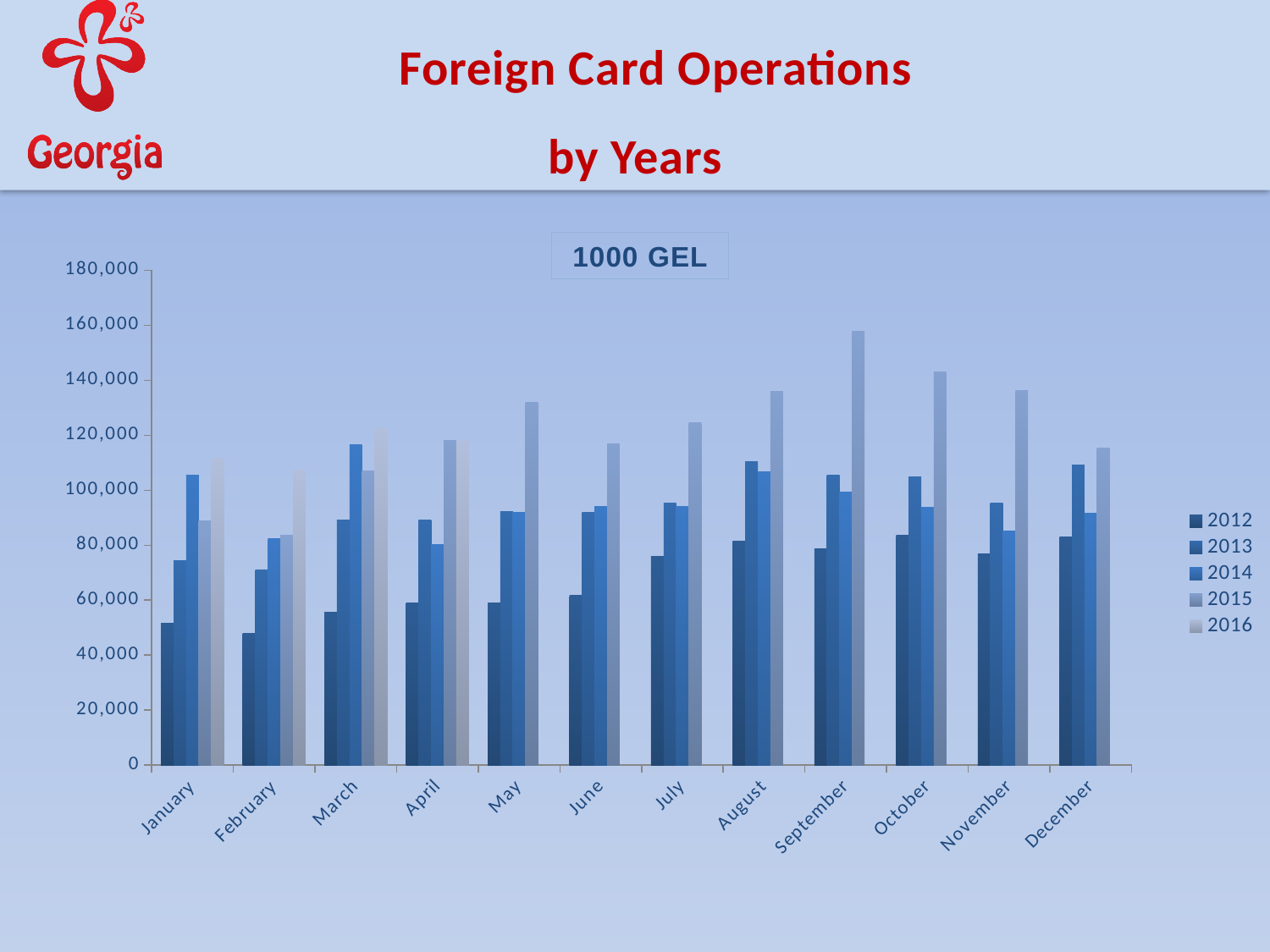
In which month is the 2015 value the highest? September How many months are shown along the x axis? 12 Is the 2015 value for September greater or less than 140,000? greater Is the 2012 value for January greater or less than 60,000? less What is the title shown above the chart? 1000 GEL Do the 2012 values generally rise or fall from January to December? Rise How many series does the legend list? 5 In January, which is larger: the 2014 value or the 2015 value? 2014 What kind of chart is shown on the slide? Bar chart For 2015, which is larger: the September value or the October value? September In which month is the 2012 value the lowest? February Is the 2016 value for March greater or less than 120,000? greater